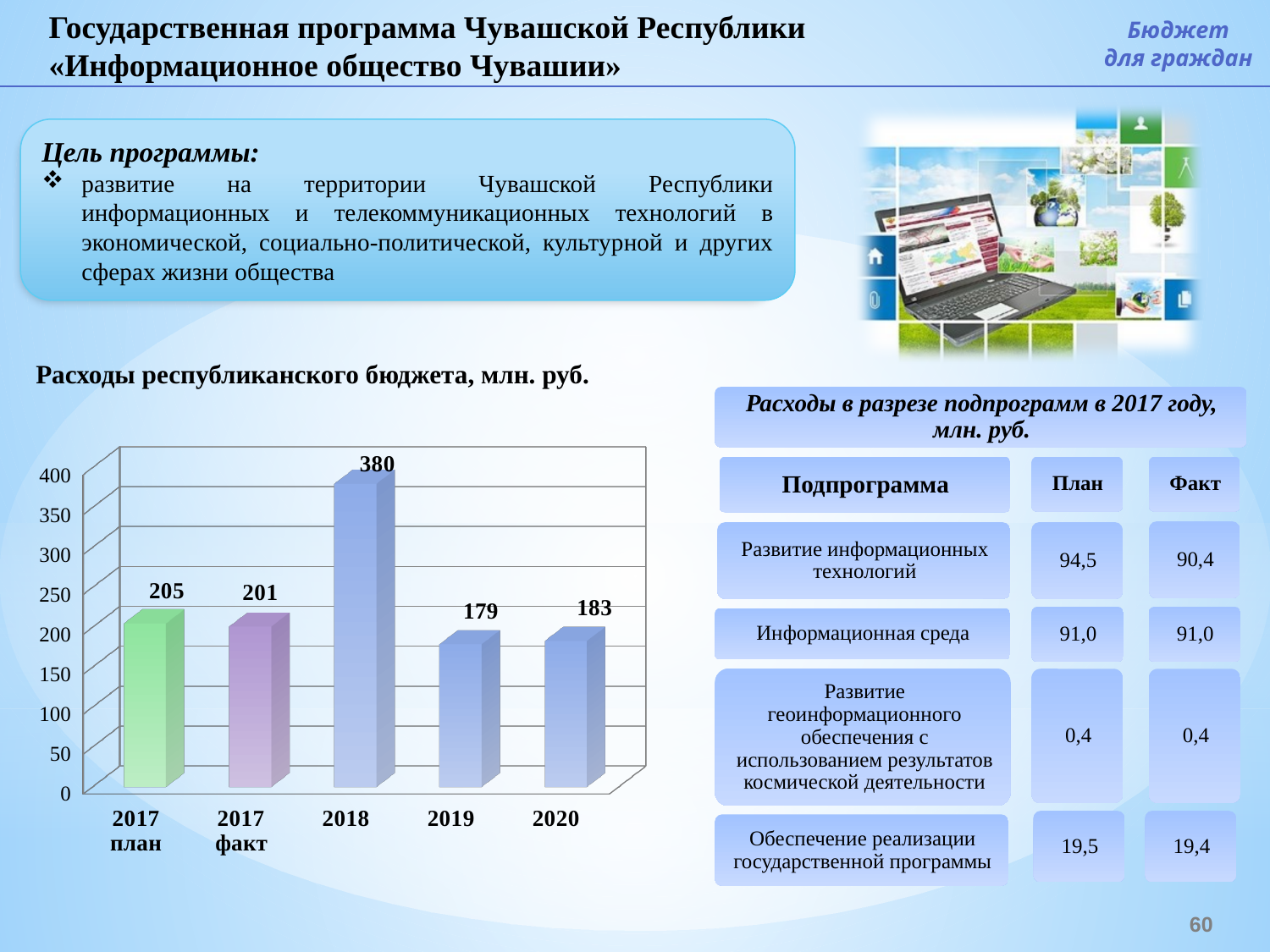
What is the value for 2018 in the chart "Расходы республиканского бюджета, млн. руб."? 380 Is the value for 2018 in the chart greater or less than 350? greater Which category has the highest value in the chart? 2018 What is the difference between "2017 план" and "2017 факт" in the chart? 4 What is the difference between the values for 2018 and 2019 in the chart? 201 Which is larger in the chart: the value for 2020 or the value for 2019? 2020 What is the value for "2017 факт" in the chart? 201 Which category has the lowest value in the chart? 2019 What is the value for "2017 план" in the chart? 205 How many bars are shown in the chart? 5 What type of chart is shown on the slide? bar chart What is the value for 2020 in the chart? 183